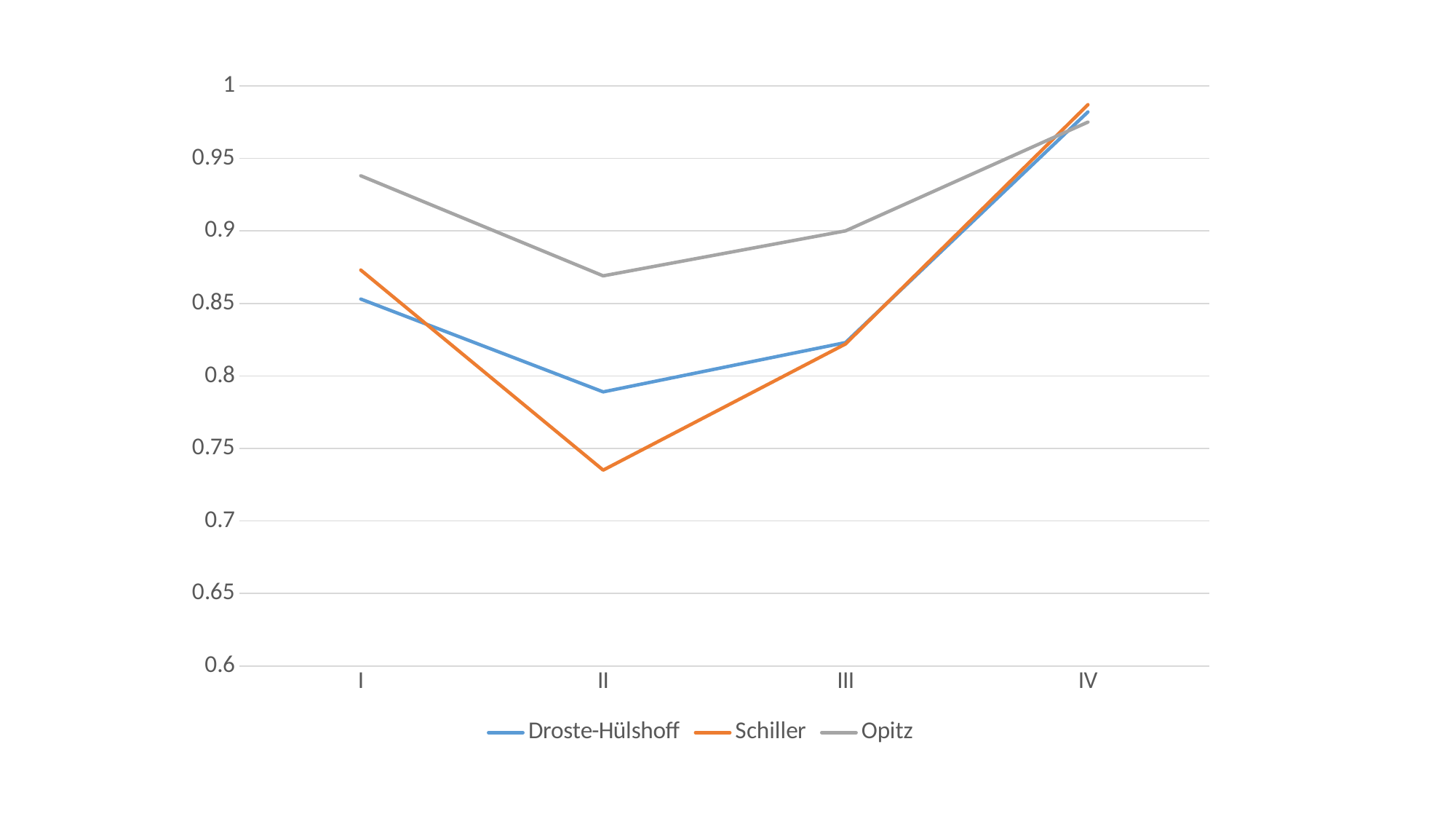
Is the value for Droste-Hülshoff at category II greater or less than 0.8? less At which category does the Schiller series reach its lowest value? II At category II, which series has the larger value, Opitz or Schiller? Opitz Which series has the lowest value at category II? Schiller Is the value for Schiller at category II greater or less than 0.75? less Which series has the highest value at category I? Opitz Is the value for Opitz at category I greater or less than 0.9? greater Does the Schiller series rise or fall from category II to category IV? rise How many categories are shown on the x axis? 4 How many series does the legend list? 3 What kind of chart is shown on the slide? line chart At which category does the Opitz series reach its highest value? IV